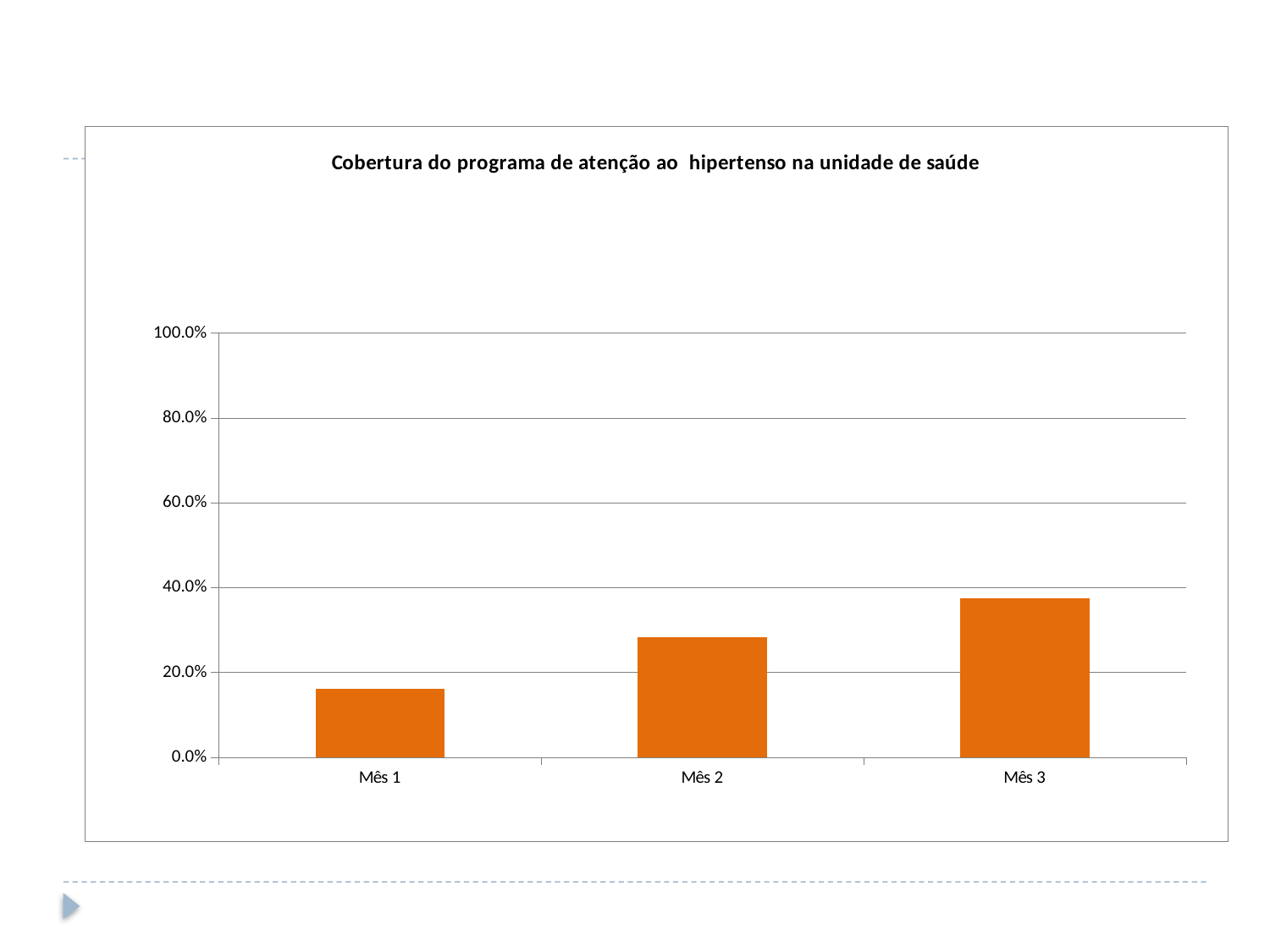
What is the title of the chart? Cobertura do programa de atenção ao hipertenso na unidade de saúde What colour are the bars in the chart? orange How many categories are plotted on the x axis? 3 What kind of chart is shown on the slide? bar chart Is the value for Mês 2 greater or less than 20.0%? greater Which month has the highest coverage value? Mês 3 Is the value for Mês 1 greater or less than 20.0%? less Do the values rise or fall from Mês 1 to Mês 3? rise Is the value for Mês 3 greater or less than 20.0%? greater Which month has the lowest coverage value? Mês 1 Which is larger, the value for Mês 1 or the value for Mês 2? Mês 2